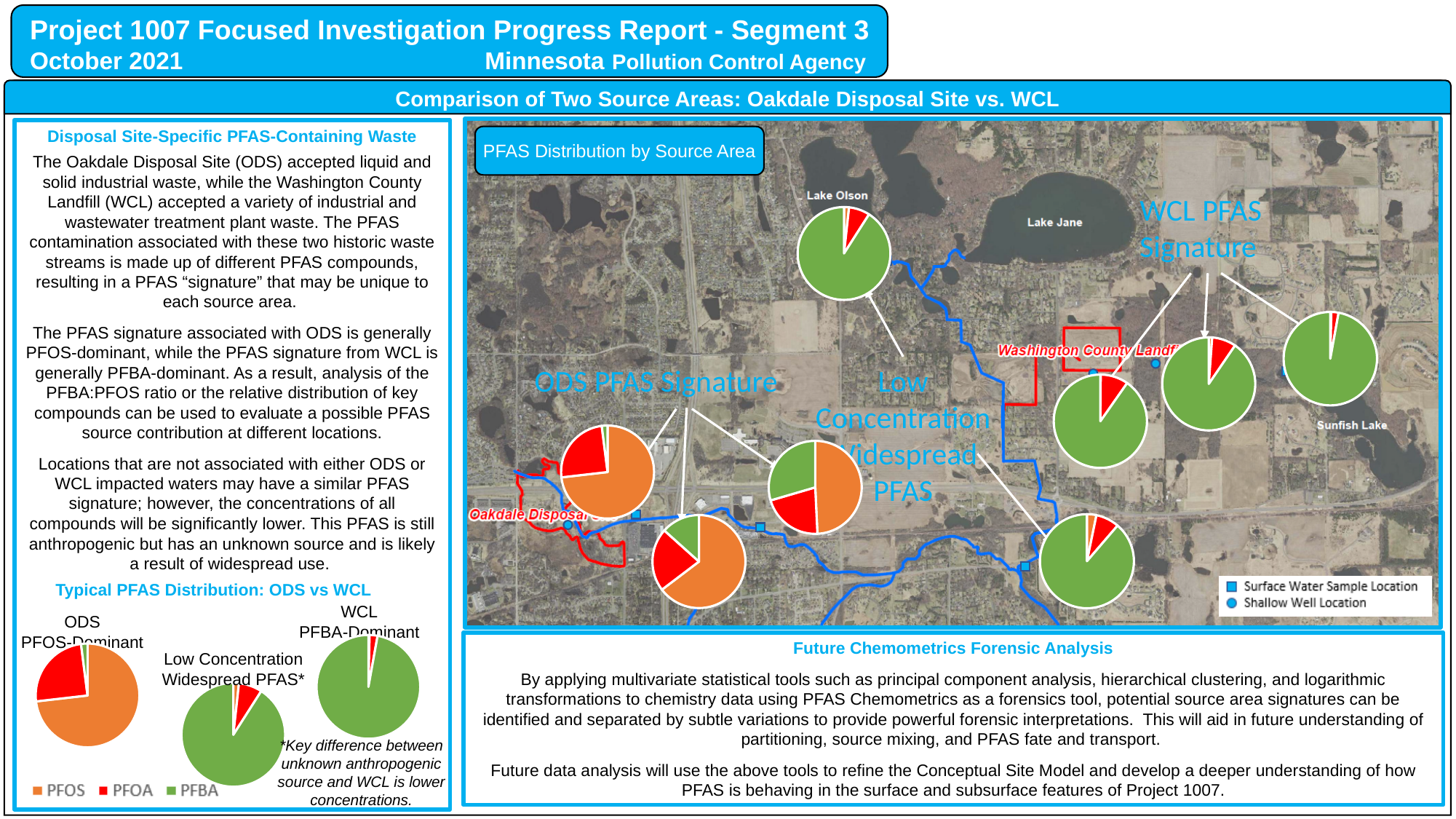
In the 'WCL PFBA-Dominant' pie chart, which slice is larger: PFBA or PFOA? PFBA In the 'PFAS Distribution by Source Area' map, which compound dominates the pie charts labelled 'WCL PFAS Signature'? PFBA In the 'Typical PFAS Distribution: ODS vs WCL' section, which compound has the smallest slice in the 'ODS PFOS-Dominant' pie chart? PFBA In the 'Typical PFAS Distribution: ODS vs WCL' legend, which colour represents PFOA? Red In the 'Typical PFAS Distribution: ODS vs WCL' section, which compound has the largest slice in the 'Low Concentration Widespread PFAS*' pie chart? PFBA How many pie charts are shown in the 'Typical PFAS Distribution: ODS vs WCL' section? 3 How many entries does the legend list in the 'Typical PFAS Distribution: ODS vs WCL' section? 3 In the 'Typical PFAS Distribution: ODS vs WCL' legend, which compound is shown in orange? PFOS What kind of chart is used in the 'Typical PFAS Distribution: ODS vs WCL' section? Pie chart In the 'Typical PFAS Distribution: ODS vs WCL' section, which compound has the largest slice in the 'ODS PFOS-Dominant' pie chart? PFOS In the 'ODS PFOS-Dominant' pie chart, which slice is larger: PFOS or PFOA? PFOS